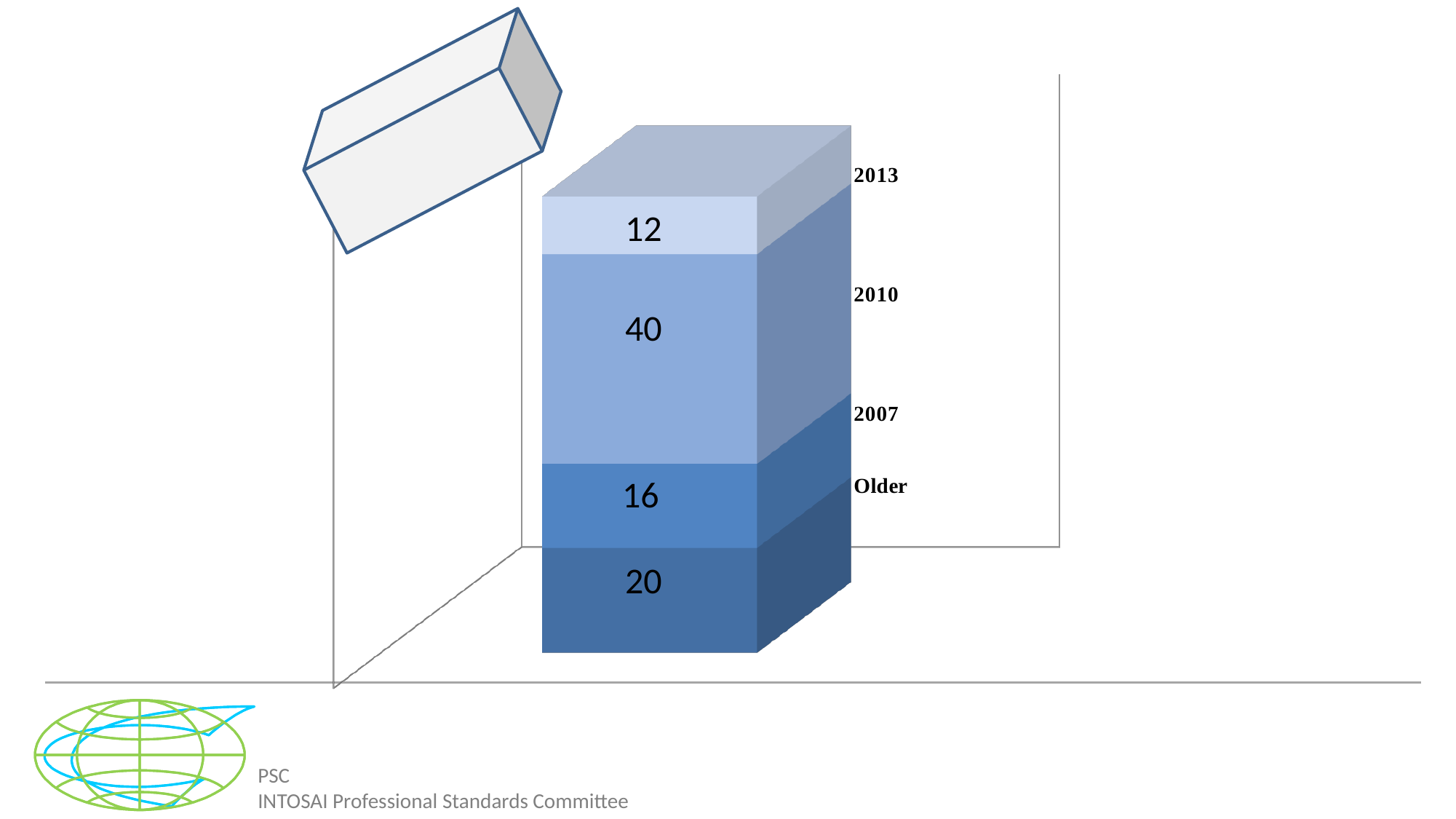
What kind of chart is shown on the slide? Stacked bar chart What is the value of the 2013 segment in the stacked bar? 12 What is the total of all segments in the stacked bar? 88 What is the value of the 2007 segment in the stacked bar? 16 What is the value of the 2010 segment in the stacked bar? 40 Which segment of the stacked bar has the smallest value? 2013 What is the difference between the 'Older' segment and the 2007 segment? 4 What is the difference between the 2010 segment and the 2013 segment? 28 Which segment of the stacked bar has the largest value? 2010 Which is larger, the 'Older' segment or the 2007 segment? Older What is the value of the 'Older' segment in the stacked bar? 20 How many segments make up the stacked bar? 4